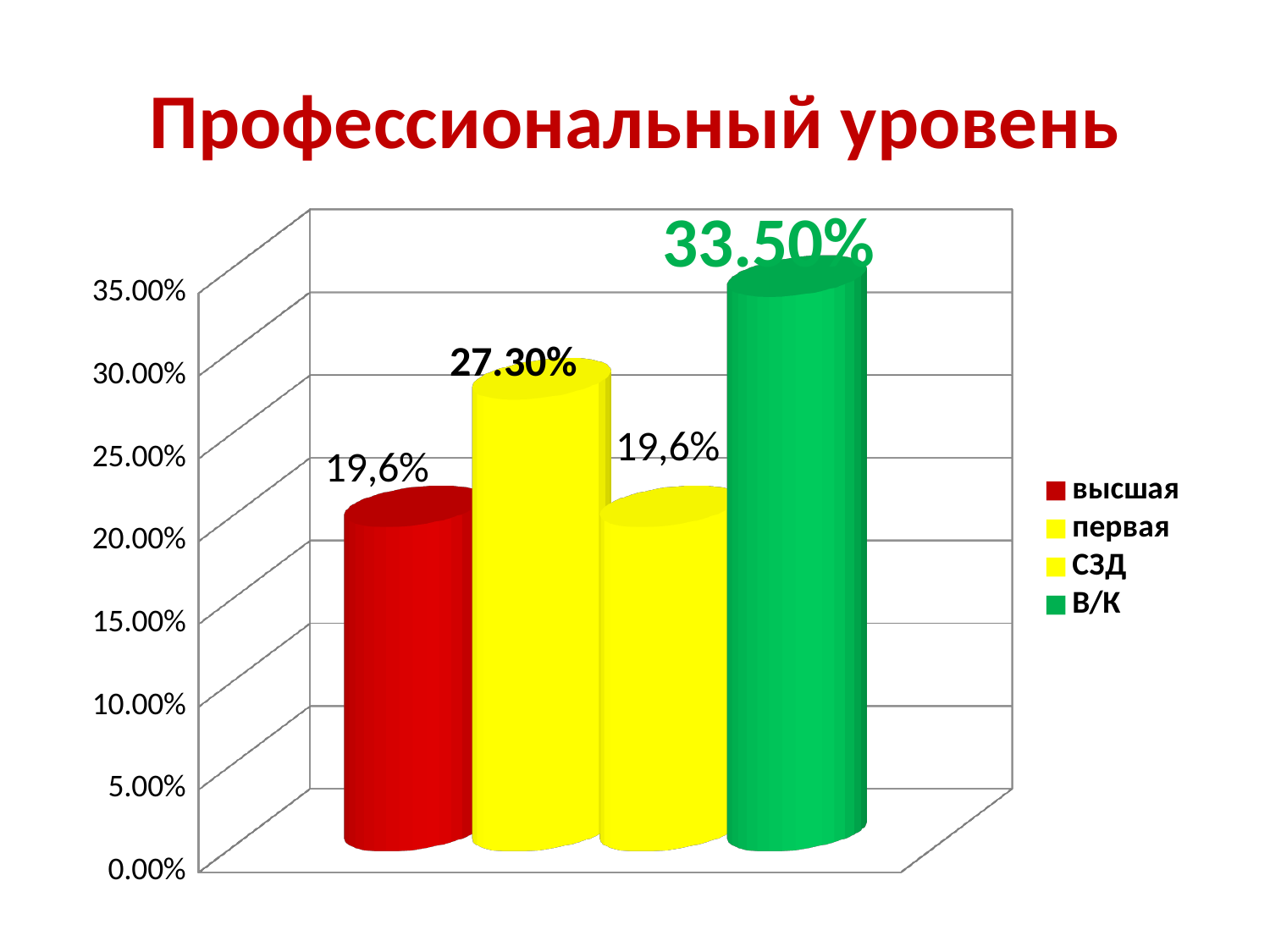
What kind of chart is shown on the slide? bar chart What is the difference between the value for В/К and the value for первая? 6.20% Is the value for В/К greater or less than 30.00%? greater What is the value for the series СЗД? 19,6% Which series has the highest value? В/К Which is larger, the value for первая or the value for СЗД? первая How many series does the legend list? 4 What is the value for the series первая? 27.30% How many bars are plotted on the chart? 4 What is the value for the series В/К? 33.50% What is the value for the series высшая? 19,6% What is the title of the slide? Профессиональный уровень